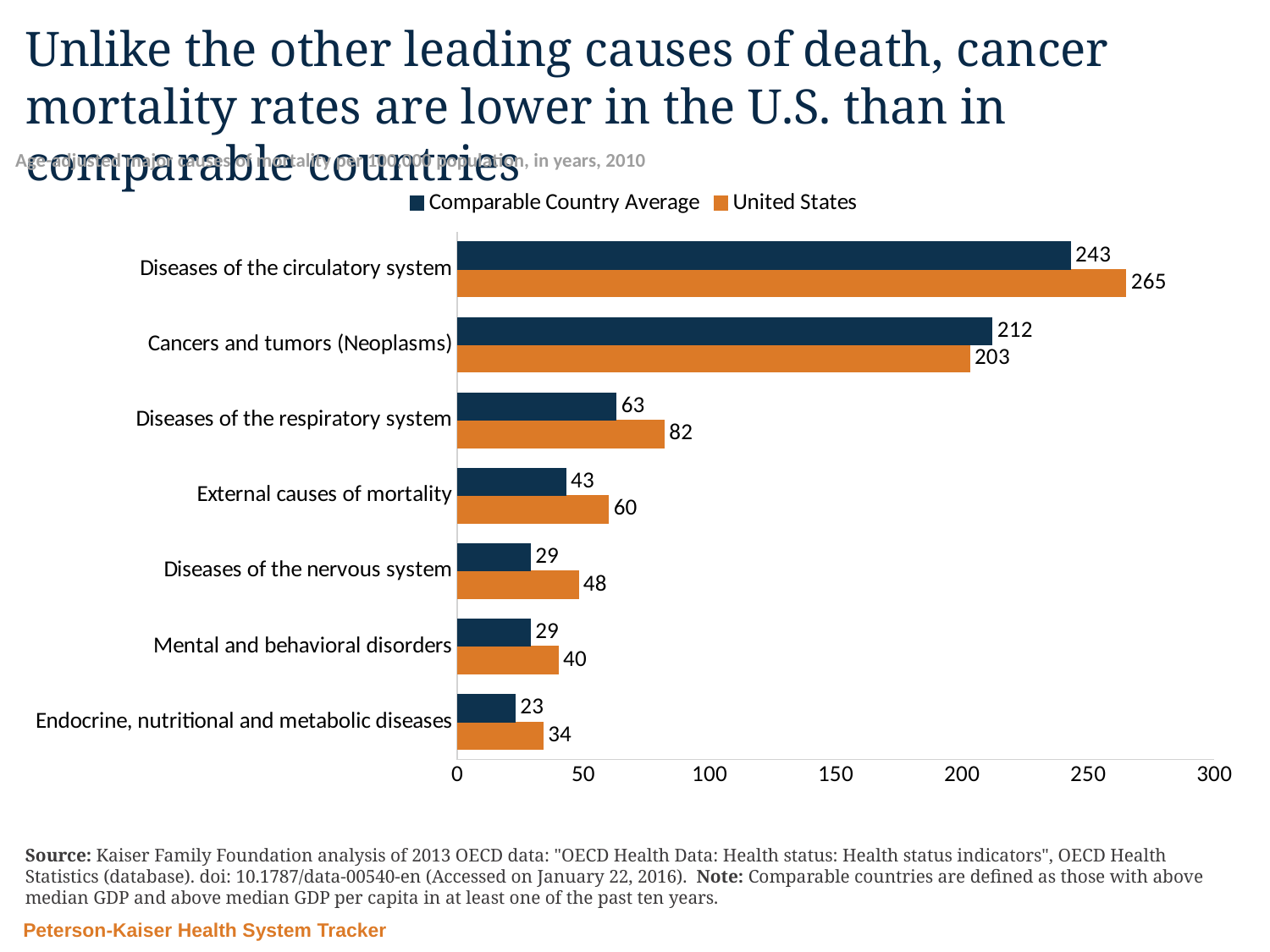
What is the United States value for Diseases of the nervous system? 48 Which category has the highest United States value? Diseases of the circulatory system Which colour represents the United States in the chart? Orange Which category has the lowest Comparable Country Average value? Endocrine, nutritional and metabolic diseases What is the United States value for Diseases of the circulatory system? 265 How many series does the legend list? 2 What kind of chart is shown on the slide? Bar chart What is the difference between the United States and Comparable Country Average values for Diseases of the respiratory system? 19 Is the United States value for External causes of mortality greater or less than 50? greater What is the Comparable Country Average value for Cancers and tumors (Neoplasms)? 212 How many categories are shown on the chart? 7 For Cancers and tumors (Neoplasms), which is larger: the Comparable Country Average or the United States value? Comparable Country Average